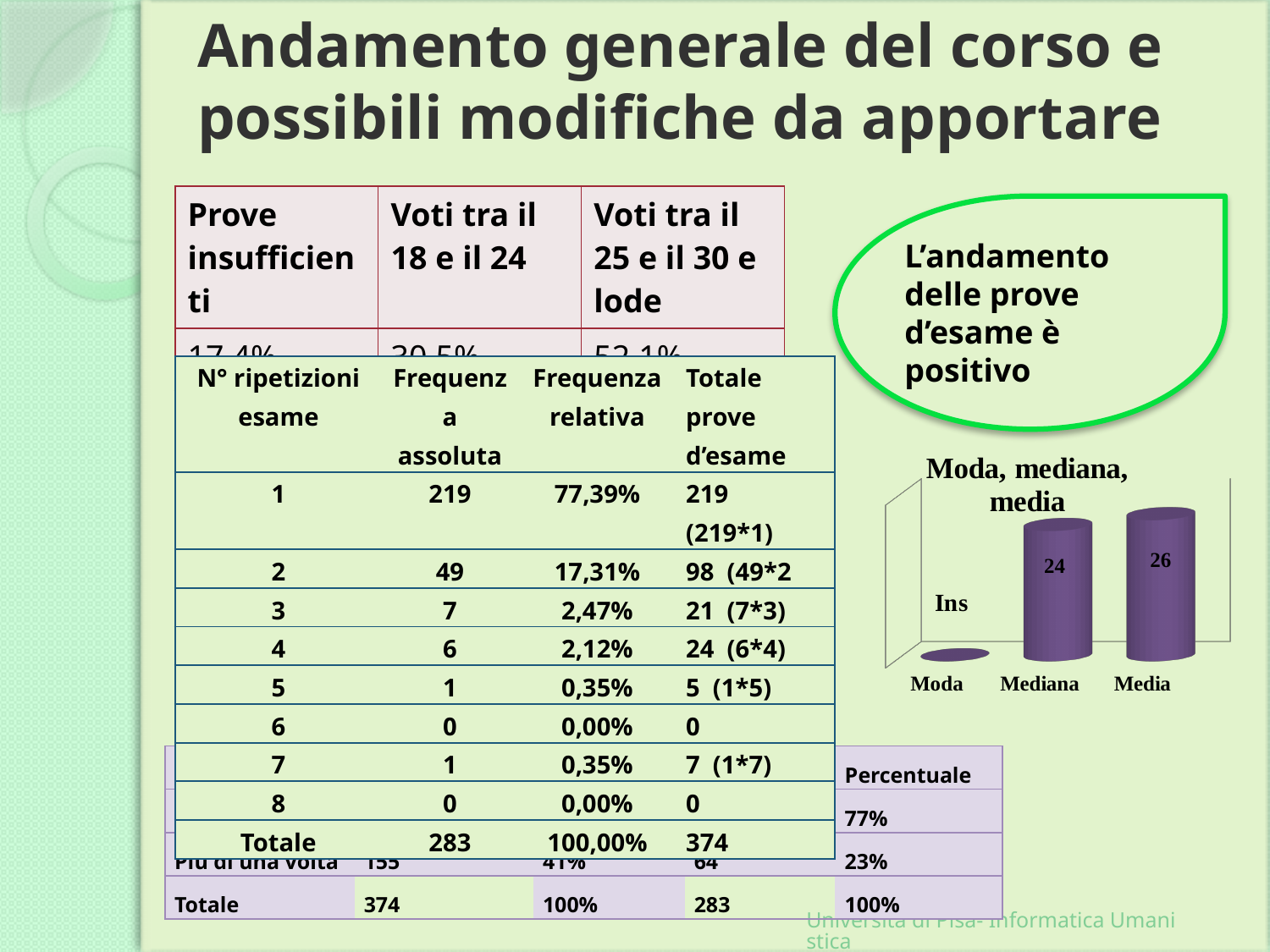
How many categories are shown on the x axis of the "Moda, mediana, media" chart? 3 In the "Moda, mediana, media" chart, what is the difference between the values for Media and Mediana? 2 What kind of chart is the "Moda, mediana, media" chart? Bar chart What is the value shown for Mediana in the "Moda, mediana, media" chart? 24 In the "Moda, mediana, media" chart, which category has the highest bar? Media What label is shown for the Moda category in the "Moda, mediana, media" chart instead of a number? Ins In the "Moda, mediana, media" chart, which category has the lowest bar? Moda What is the title of the chart on the slide? Moda, mediana, media In the "Moda, mediana, media" chart, which is larger: the value for Mediana or the value for Media? Media What is the value shown for Media in the "Moda, mediana, media" chart? 26 Do the bars in the "Moda, mediana, media" chart rise or fall from left to right? Rise